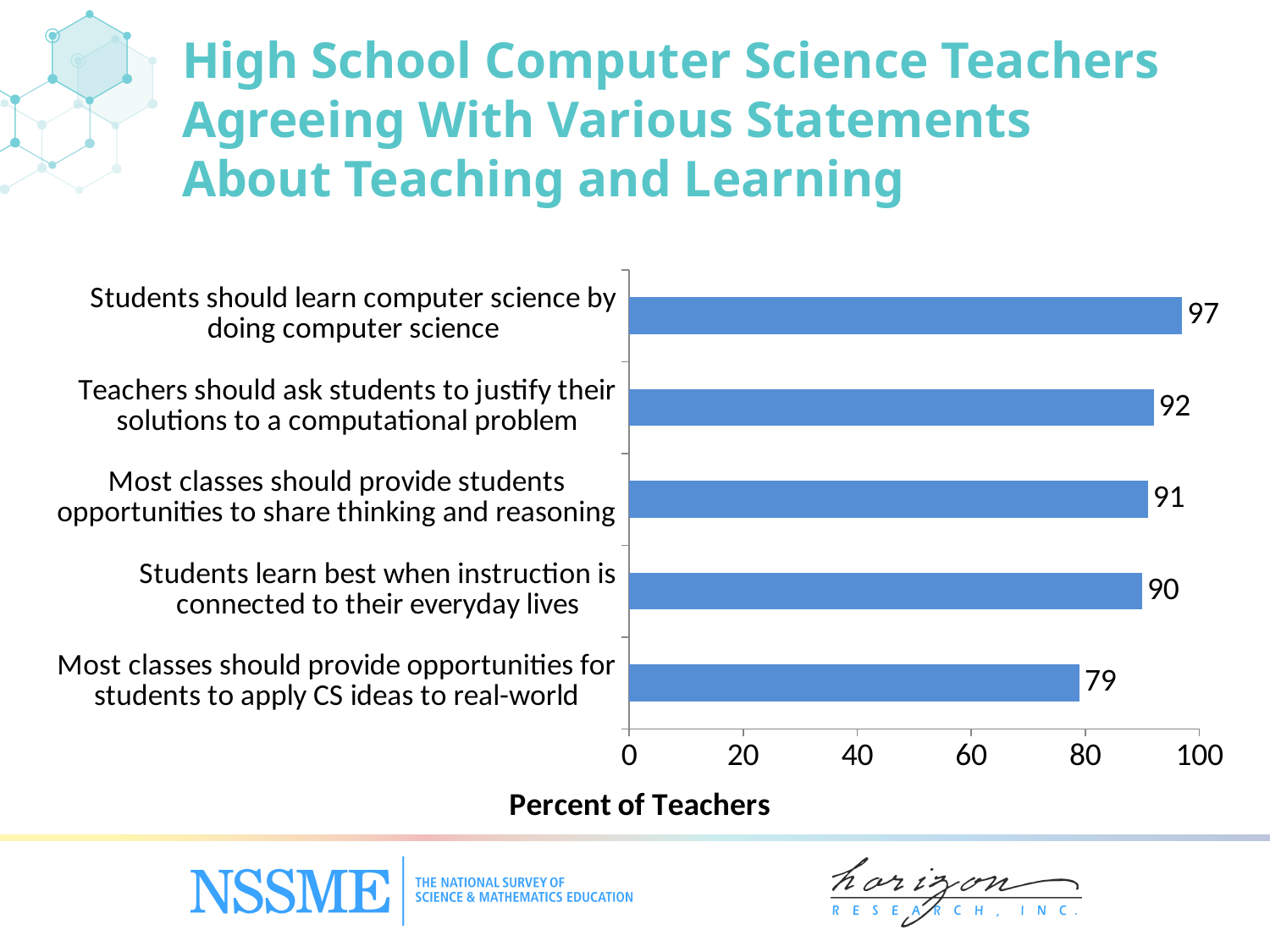
What is the label of the horizontal axis? Percent of Teachers What is the difference in percent of teachers between 'Students should learn computer science by doing computer science' and 'Most classes should provide opportunities for students to apply CS ideas to real-world'? 18 Which statement has the highest percent of teachers agreeing? Students should learn computer science by doing computer science Which has a higher percent of teachers agreeing: 'Teachers should ask students to justify their solutions to a computational problem' or 'Most classes should provide opportunities for students to apply CS ideas to real-world'? Teachers should ask students to justify their solutions to a computational problem What percent of teachers agree that students should learn computer science by doing computer science? 97 What kind of chart is shown on the slide? Bar chart Which statement has the lowest percent of teachers agreeing? Most classes should provide opportunities for students to apply CS ideas to real-world Is the value for 'Most classes should provide opportunities for students to apply CS ideas to real-world' greater or less than 80? less What is the difference in percent of teachers between 'Teachers should ask students to justify their solutions to a computational problem' and 'Students learn best when instruction is connected to their everyday lives'? 2 How many statements are shown in the chart? 5 What percent of teachers agree that most classes should provide opportunities for students to apply CS ideas to real-world? 79 What percent of teachers agree that students learn best when instruction is connected to their everyday lives? 90